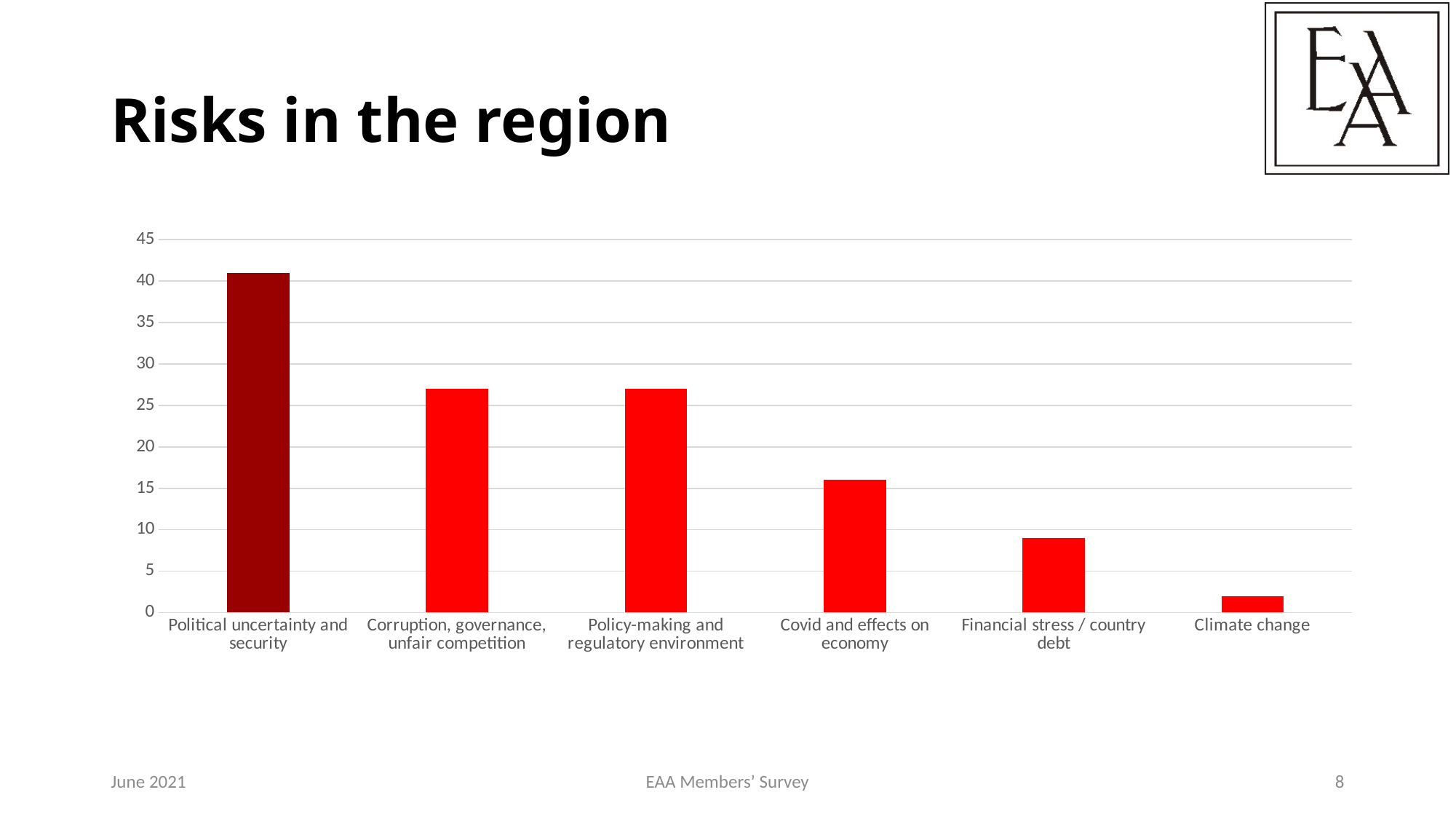
Is the value for Corruption, governance, unfair competition greater or less than 25? greater What kind of chart is shown on the slide? bar chart Which risk category has the lowest value? Climate change Is the value for Financial stress / country debt greater or less than 15? less Which is larger, the value for Covid and effects on economy or the value for Financial stress / country debt? Covid and effects on economy What is the title of the slide containing the chart? Risks in the region Which risk category has the highest value? Political uncertainty and security How many risk categories are plotted on the chart? 6 Is the value for Climate change greater or less than 5? less Do the values rise or fall moving from left to right along the x axis? fall